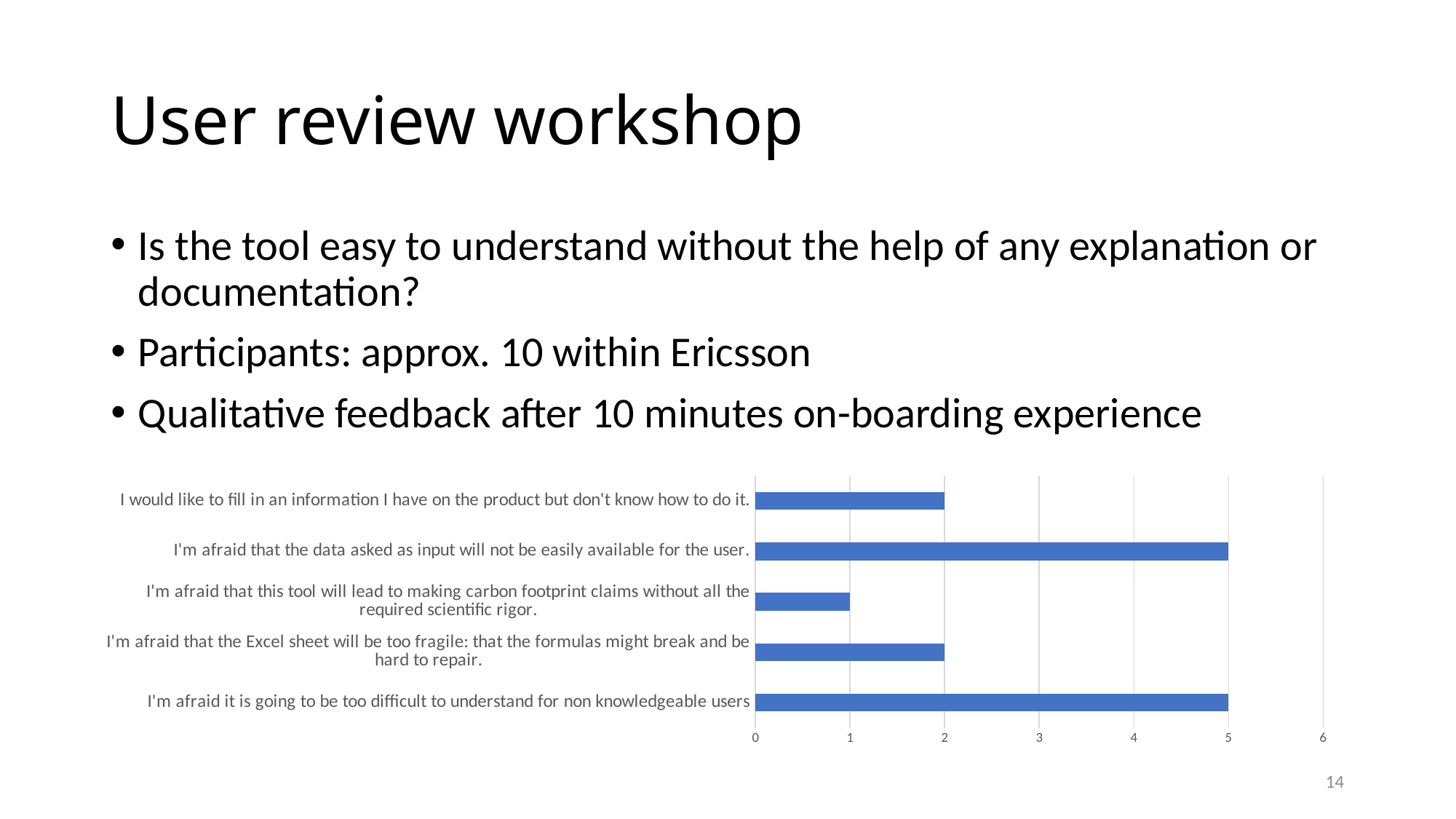
How many categories (feedback statements) does the chart show? 5 What is the difference between the value for "I'm afraid that the data asked as input will not be easily available for the user." and the value for "I'm afraid that the Excel sheet will be too fragile: that the formulas might break and be hard to repair."? 3 What colour are the bars in the chart? Blue What is the value for "I'm afraid it is going to be too difficult to understand for non knowledgeable users"? 5 Which has a larger value: "I would like to fill in an information I have on the product but don't know how to do it." or "I'm afraid that this tool will lead to making carbon footprint claims without all the required scientific rigor."? I would like to fill in an information I have on the product but don't know how to do it. What is the value for "I would like to fill in an information I have on the product but don't know how to do it."? 2 What is the value for "I'm afraid that the data asked as input will not be easily available for the user."? 5 What is the highest value shown on the horizontal axis of the chart? 6 What is the value for "I'm afraid that this tool will lead to making carbon footprint claims without all the required scientific rigor."? 1 Is the value for "I'm afraid it is going to be too difficult to understand for non knowledgeable users" greater or less than 3? greater What kind of chart is shown on the slide? Bar chart Which feedback statement has the lowest value? I'm afraid that this tool will lead to making carbon footprint claims without all the required scientific rigor.